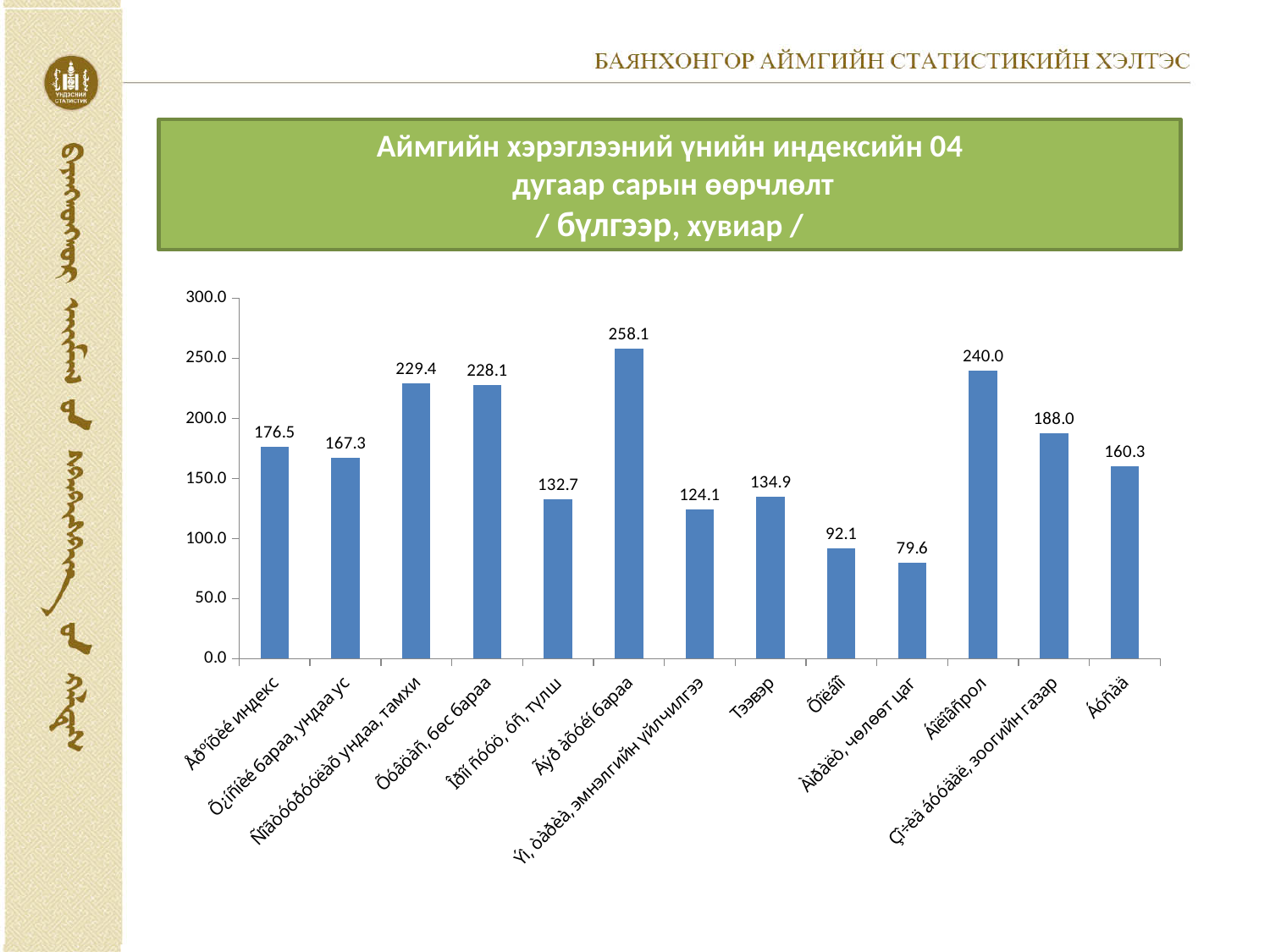
What is the lowest value shown in the chart? 79.6 What is the highest value shown in the chart? 258.1 What kind of chart is shown on the slide? bar chart What is the difference between the highest value (258.1) and the lowest value (79.6) in the chart? 178.5 What is the value of the second bar from the left? 167.3 Is the value for Тээвэр greater or less than 150? less Which is larger: the value of the leftmost bar or the value of the rightmost bar? the leftmost bar (176.5) What is the value of the rightmost bar in the chart? 160.3 What is the title of the chart on the slide? Аймгийн хэрэглээний үнийн индексийн 04 дугаар сарын өөрчлөлт / бүлгээр, хувиар / How many bars (categories) does the chart show? 13 What is the value of the leftmost bar in the chart? 176.5 What is the value for Тээвэр? 134.9